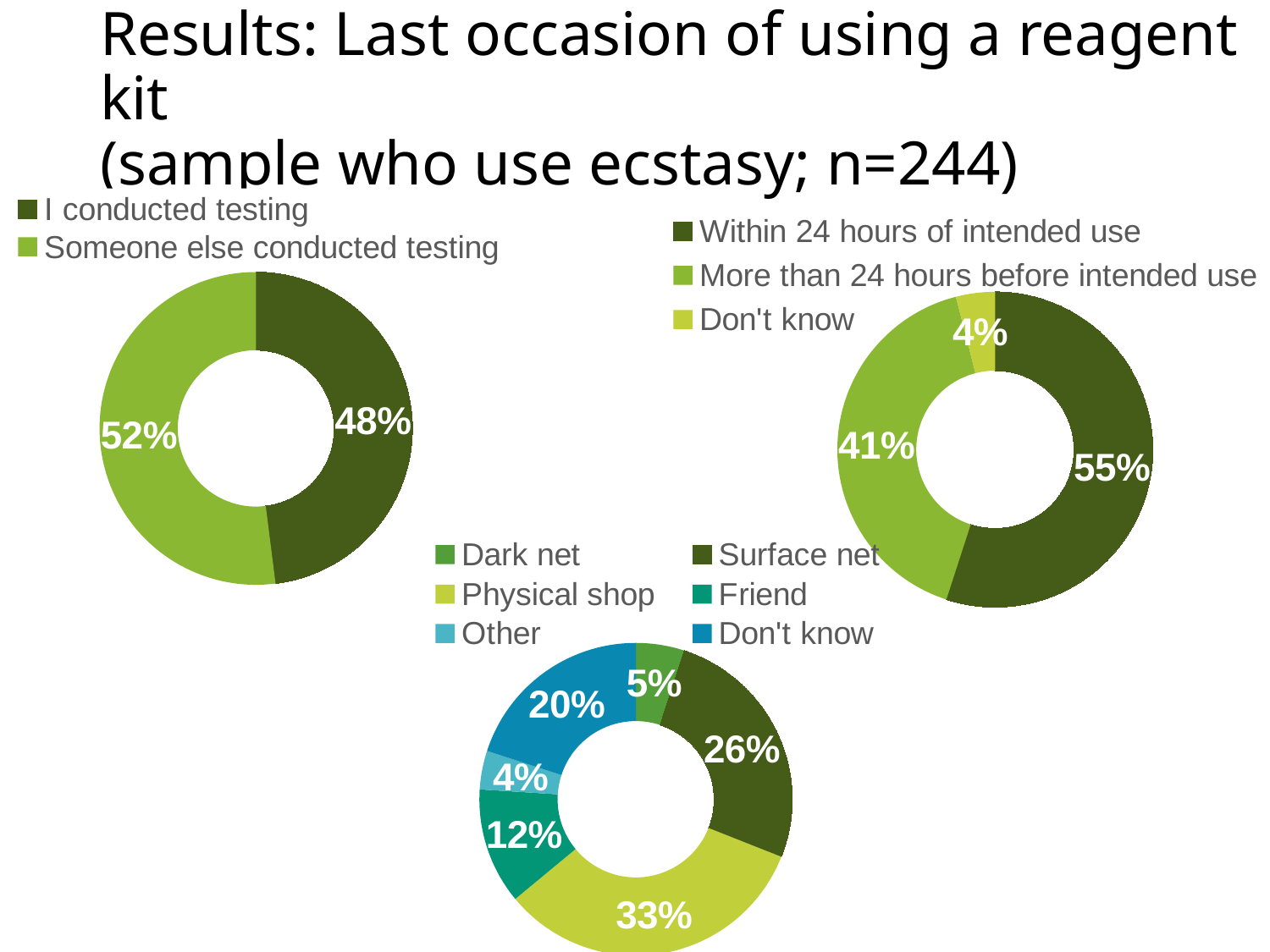
In the left doughnut chart, which category has the larger share? Someone else conducted testing In the bottom doughnut chart, which category has the largest share? Physical shop What kind of chart is the bottom chart? Doughnut (pie) chart In the bottom doughnut chart, what share is labelled for 'Physical shop'? 33% In the left doughnut chart, what share is labelled for 'Someone else conducted testing'? 52% In the right doughnut chart, what share is labelled for 'Don't know'? 4% In the bottom doughnut chart, which category has the smallest share? Other In the right doughnut chart, what is the difference between 'Within 24 hours of intended use' and 'More than 24 hours before intended use'? 14% In the right doughnut chart, what share is labelled for 'Within 24 hours of intended use'? 55% In the right doughnut chart, how many categories does the legend list? 3 In the left doughnut chart, what share is labelled for 'I conducted testing'? 48% In the bottom doughnut chart, which is larger: 'Surface net' or 'Don't know'? Surface net